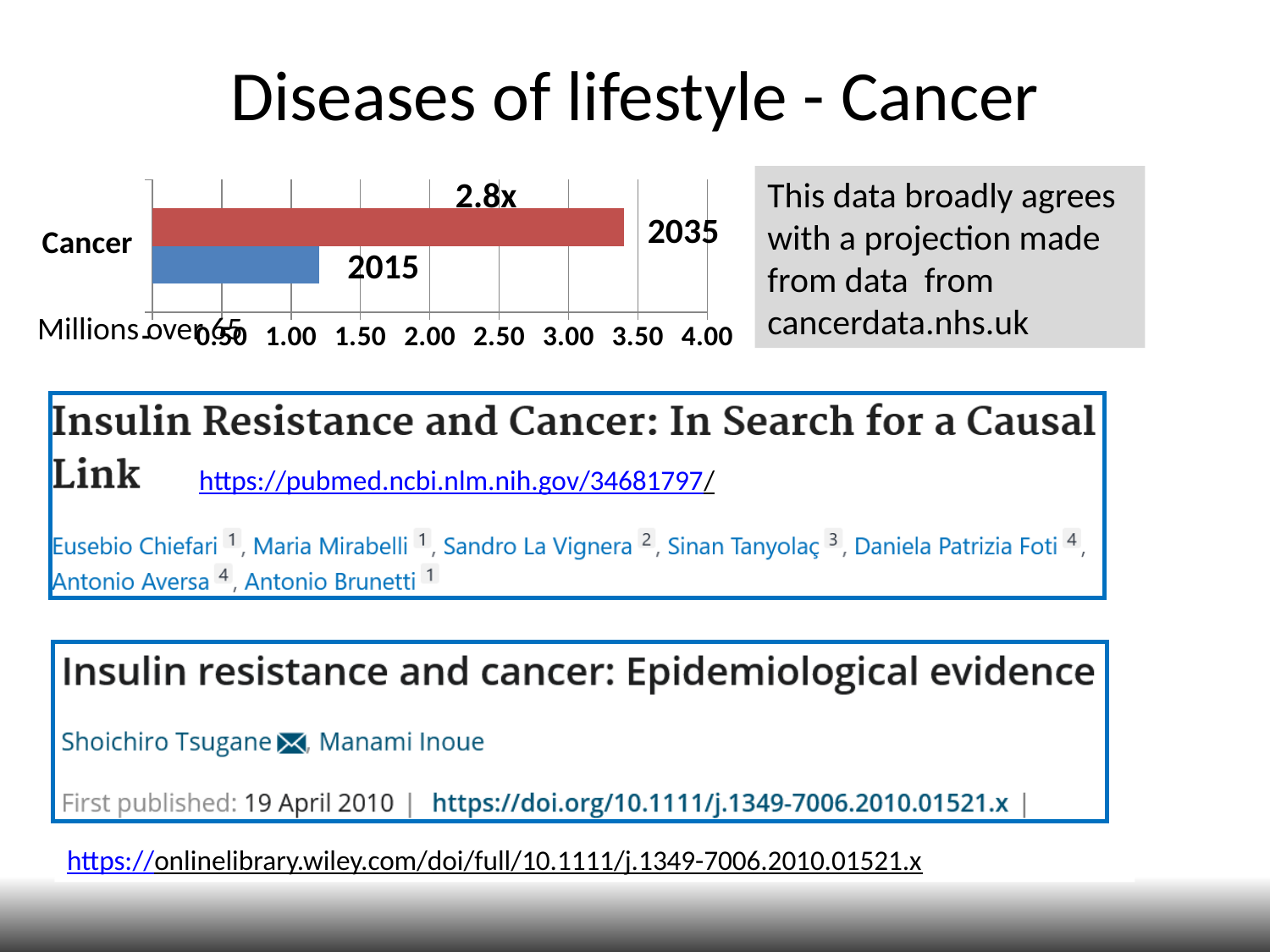
Which bar is longer, the one for 2015 or the one for 2035? 2035 What multiplier is annotated above the 2035 bar on the chart? 2.8x What is the category label shown on the chart's vertical axis? Cancer How many categories are plotted on the chart? 1 How many bars does the chart show? 2 Is the value for 2035 greater or less than 4.00? less What kind of chart is shown on the slide? bar chart Is the value for 2015 greater or less than 1.00? greater Is the value for 2015 greater or less than 1.50? less